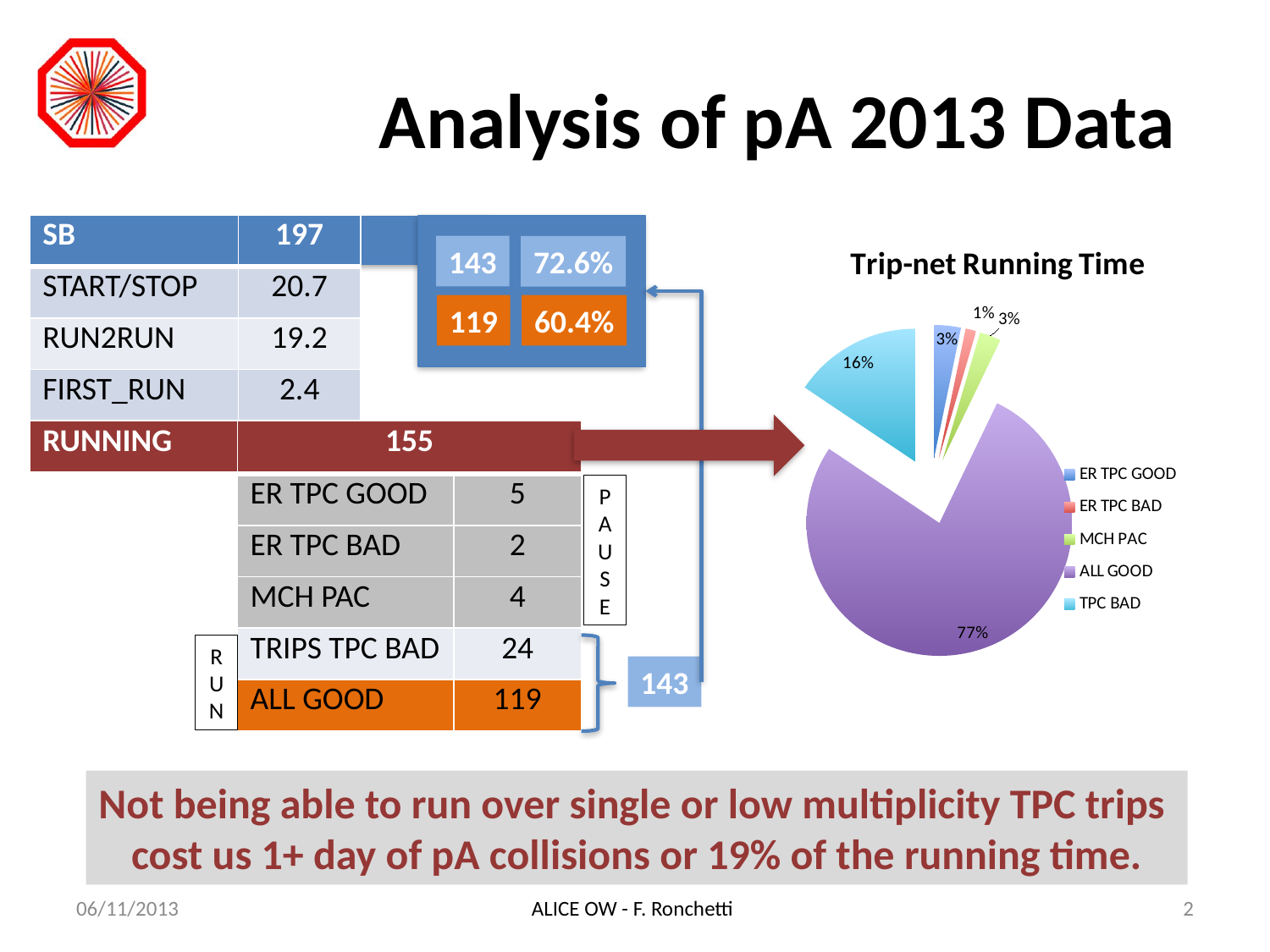
In the "Trip-net Running Time" pie chart, what percentage is shown for MCH PAC? 3% What is the title of the pie chart on the slide? Trip-net Running Time How many entries does the legend of the "Trip-net Running Time" pie chart list? 5 In the "Trip-net Running Time" pie chart, which is larger: TPC BAD or MCH PAC? TPC BAD In the "Trip-net Running Time" pie chart, what share is labelled for ALL GOOD? 77% How many slices does the "Trip-net Running Time" pie chart have? 5 In the "Trip-net Running Time" pie chart, what percentage is shown for ER TPC BAD? 1% Which category has the largest slice in the "Trip-net Running Time" pie chart? ALL GOOD In the "Trip-net Running Time" pie chart, what is the difference between the ALL GOOD share and the TPC BAD share? 61% What kind of chart is the "Trip-net Running Time" chart? pie chart Which category has the smallest slice in the "Trip-net Running Time" pie chart? ER TPC BAD In the "Trip-net Running Time" pie chart, what percentage is shown for TPC BAD? 16%